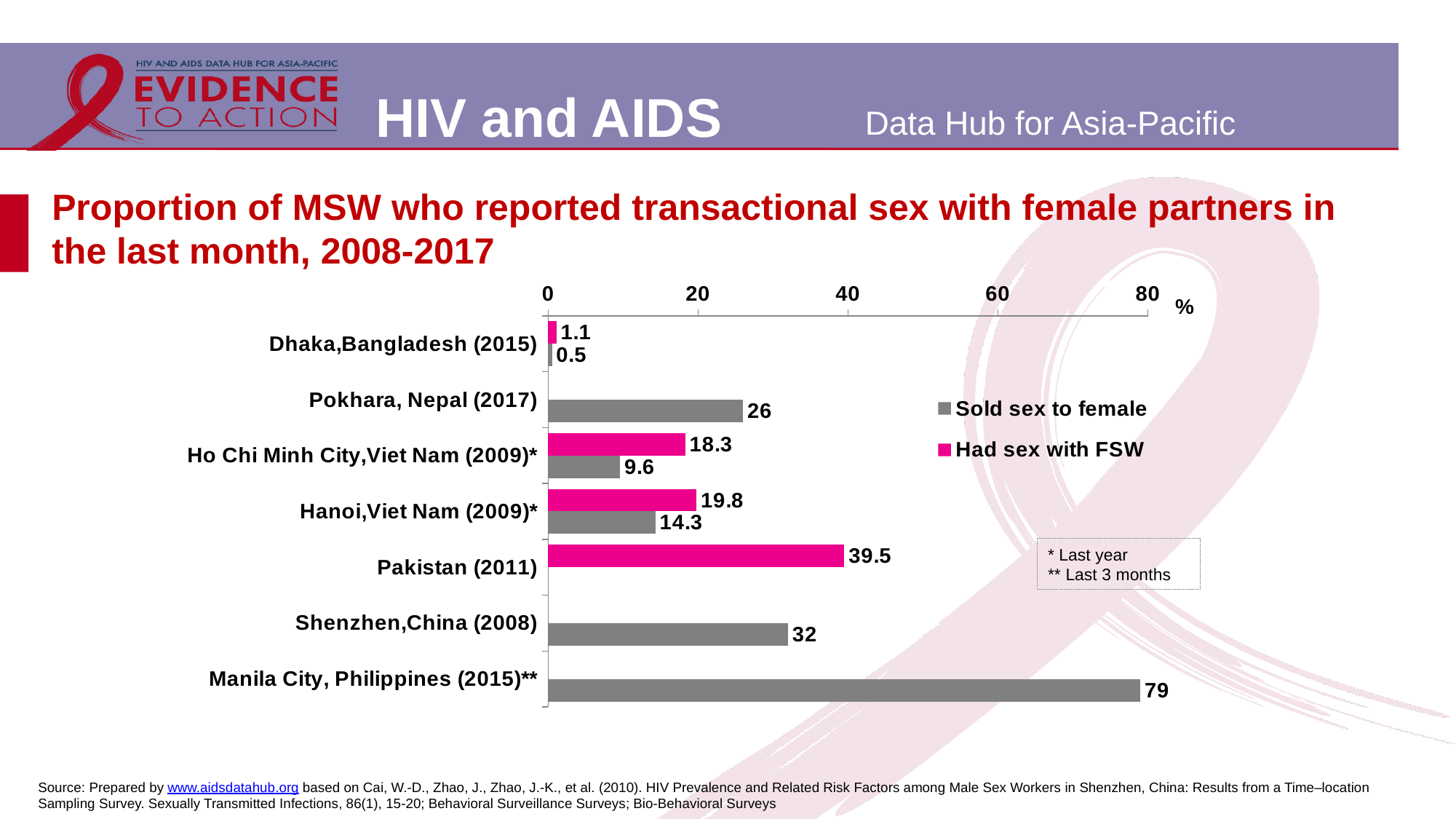
Which is larger: the 'Sold sex to female' value for Shenzhen, China (2008) or for Pokhara, Nepal (2017)? Shenzhen, China (2008) What is the difference between the 'Had sex with FSW' and 'Sold sex to female' values for Hanoi, Viet Nam (2009)*? 5.5 Which category has the lowest 'Had sex with FSW' value? Dhaka, Bangladesh (2015) How many categories (locations) are shown on the chart? 7 What does the footnote say a single asterisk (*) indicates? Last year What is the 'Had sex with FSW' value for Pakistan (2011)? 39.5 What kind of chart is shown on the slide? Bar chart What is the 'Had sex with FSW' value for Ho Chi Minh City, Viet Nam (2009)*? 18.3 How many series does the legend list? 2 Which category has the highest 'Sold sex to female' value? Manila City, Philippines (2015)** What is the 'Sold sex to female' value for Hanoi, Viet Nam (2009)*? 14.3 What is the 'Sold sex to female' value for Manila City, Philippines (2015)**? 79